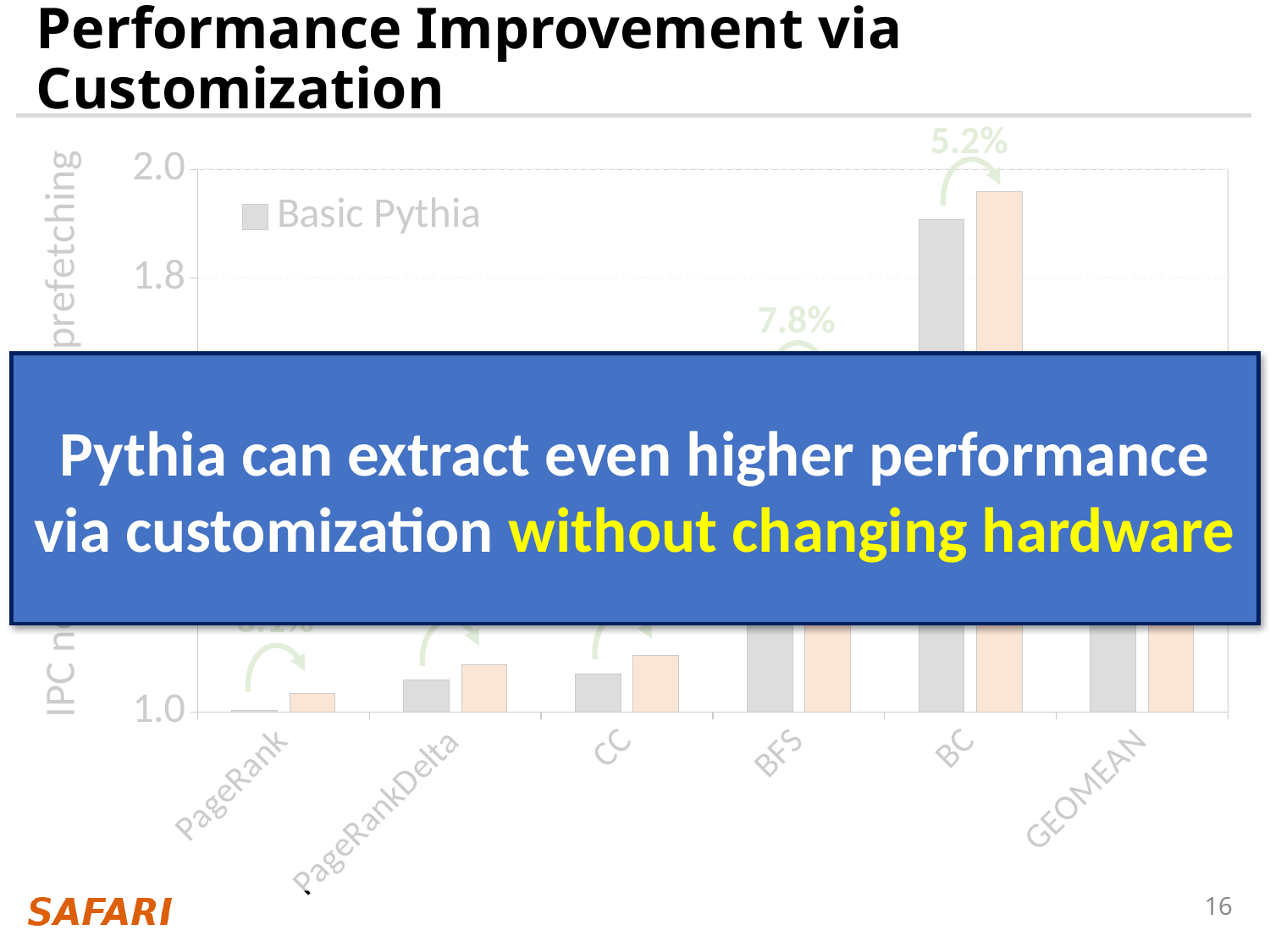
Which category has a larger value, BC or PageRank? BC What kind of chart is shown on the slide? bar chart Which annotated improvement is larger, the one for BFS or the one for BC? BFS Is the value of the grey bar for PageRank greater or less than 1.8? less What is the difference between the annotated improvement for BFS and the annotated improvement for BC? 2.6 percentage points Is the value of the orange bar for BC greater or less than 1.8? greater Which category has the lowest bars in the chart? PageRank Which category has the highest bars in the chart? BC What is the legend entry shown for the grey bars? Basic Pythia What is the percentage improvement annotated above the BC bars? 5.2% What is the percentage improvement annotated above the BFS bars? 7.8% How many categories are shown along the x axis of the chart? 6